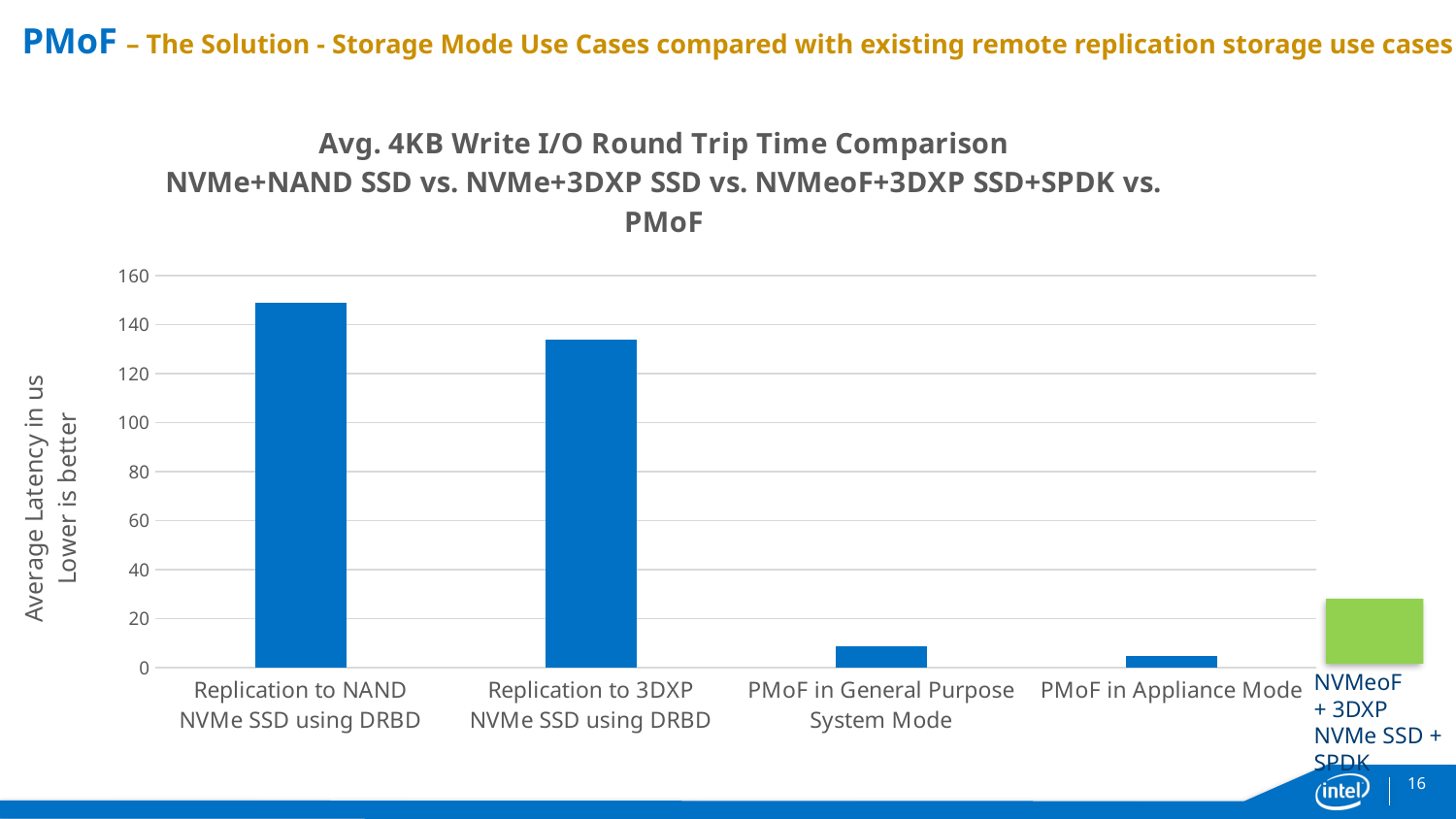
How many blue bars are plotted in the chart? 4 Which category has the lowest average latency? PMoF in Appliance Mode Is the value for PMoF in General Purpose System Mode greater or less than 20? less What is the label of the y axis? Average Latency in us Lower is better Is the value for PMoF in Appliance Mode greater or less than 20? less What kind of chart is shown on the slide? bar chart Which category has the highest average latency? Replication to NAND NVMe SSD using DRBD Is the value for Replication to 3DXP NVMe SSD using DRBD greater or less than 140? less Which has the larger average latency, Replication to 3DXP NVMe SSD using DRBD or PMoF in General Purpose System Mode? Replication to 3DXP NVMe SSD using DRBD Do the values of the blue bars rise or fall from left to right along the x axis? fall